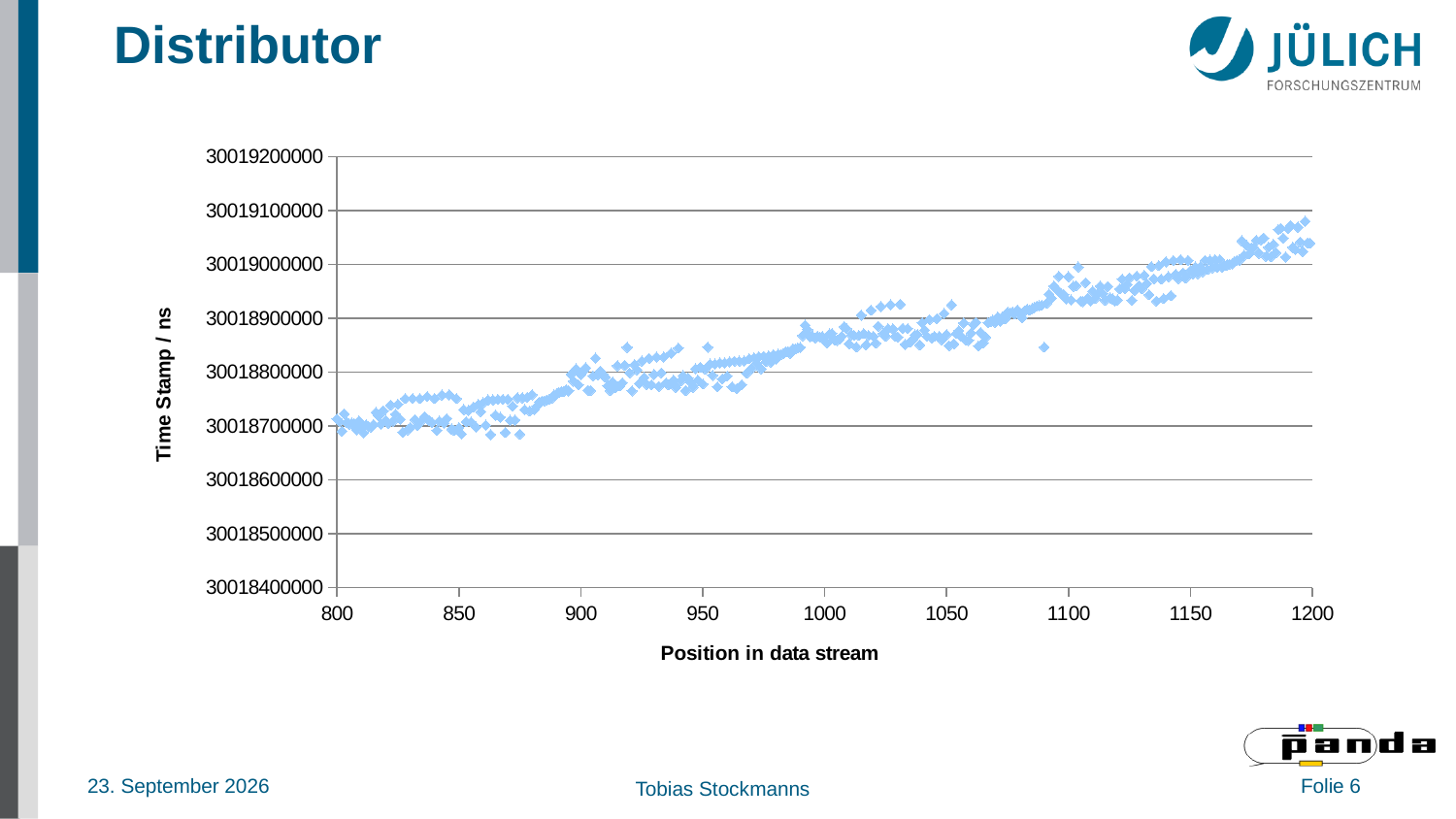
What is the title of the x axis? Position in data stream Is the time stamp value at position 1100 greater or less than 30018900000? greater What is the title of the y axis? Time Stamp / ns What is the highest value shown on the x axis? 1200 Are the time stamp values at position 1200 larger or smaller than those at position 800? larger Do the time stamp values rise or fall as the position in the data stream increases from 800 to 1200? rise Is the time stamp value at position 800 greater or less than 30018800000? less Is the time stamp value at position 850 greater or less than 30018800000? less What kind of chart is shown on the slide? scatter chart